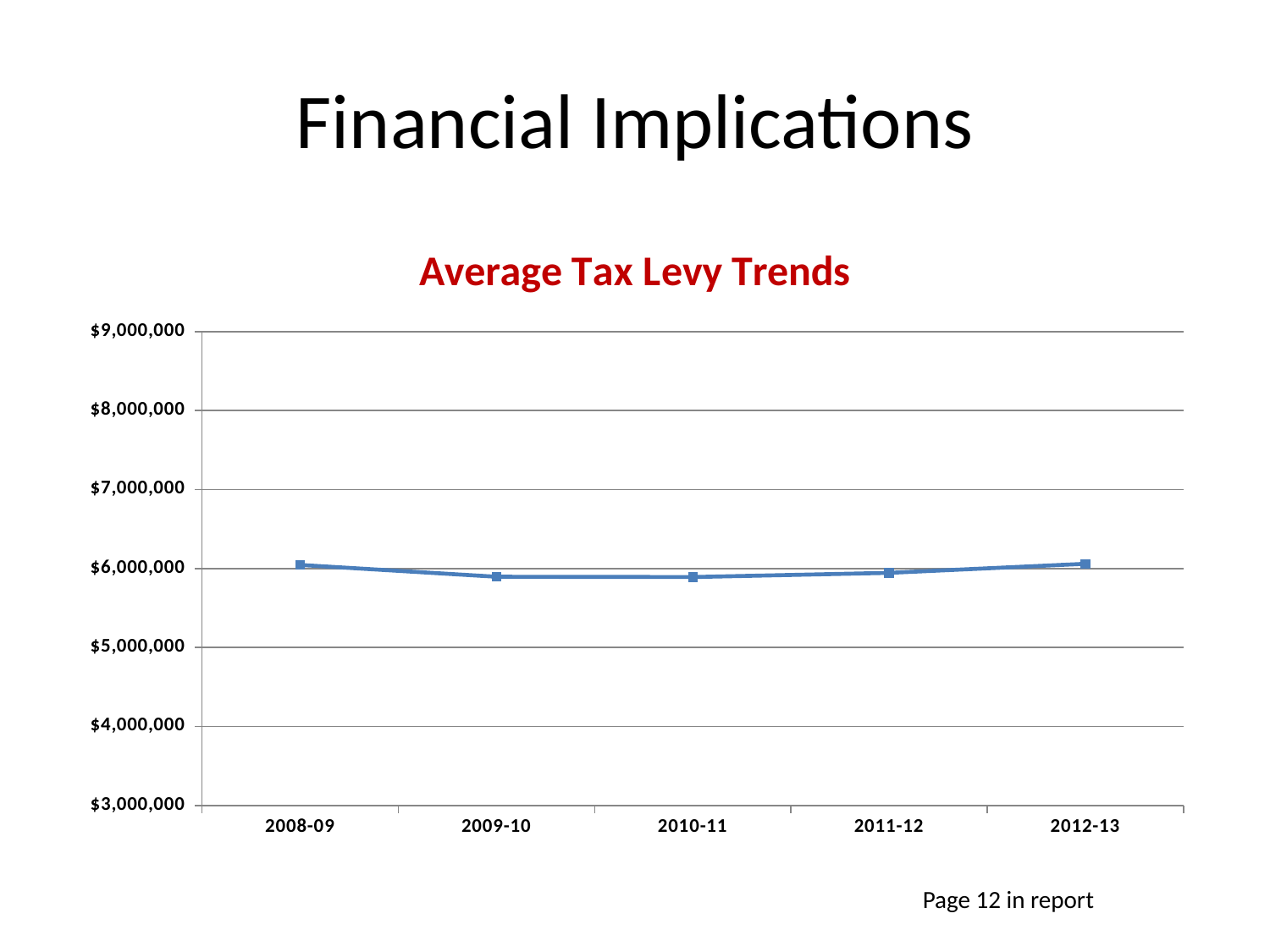
What kind of chart is shown on the slide? line chart What is the title of the chart? Average Tax Levy Trends Which is larger, the value for 2010-11 or the value for 2012-13? 2012-13 How many data points are plotted on the line? 5 Which is larger, the value for 2008-09 or the value for 2009-10? 2008-09 Does the line rise or fall from 2008-09 to 2009-10? fall Is the value for 2010-11 greater or less than $5,000,000? greater Is the value for 2012-13 greater or less than $7,000,000? less Is the value for 2008-09 greater or less than $7,000,000? less What is the lowest value shown on the vertical axis? $3,000,000 Does the line rise or fall from 2011-12 to 2012-13? rise